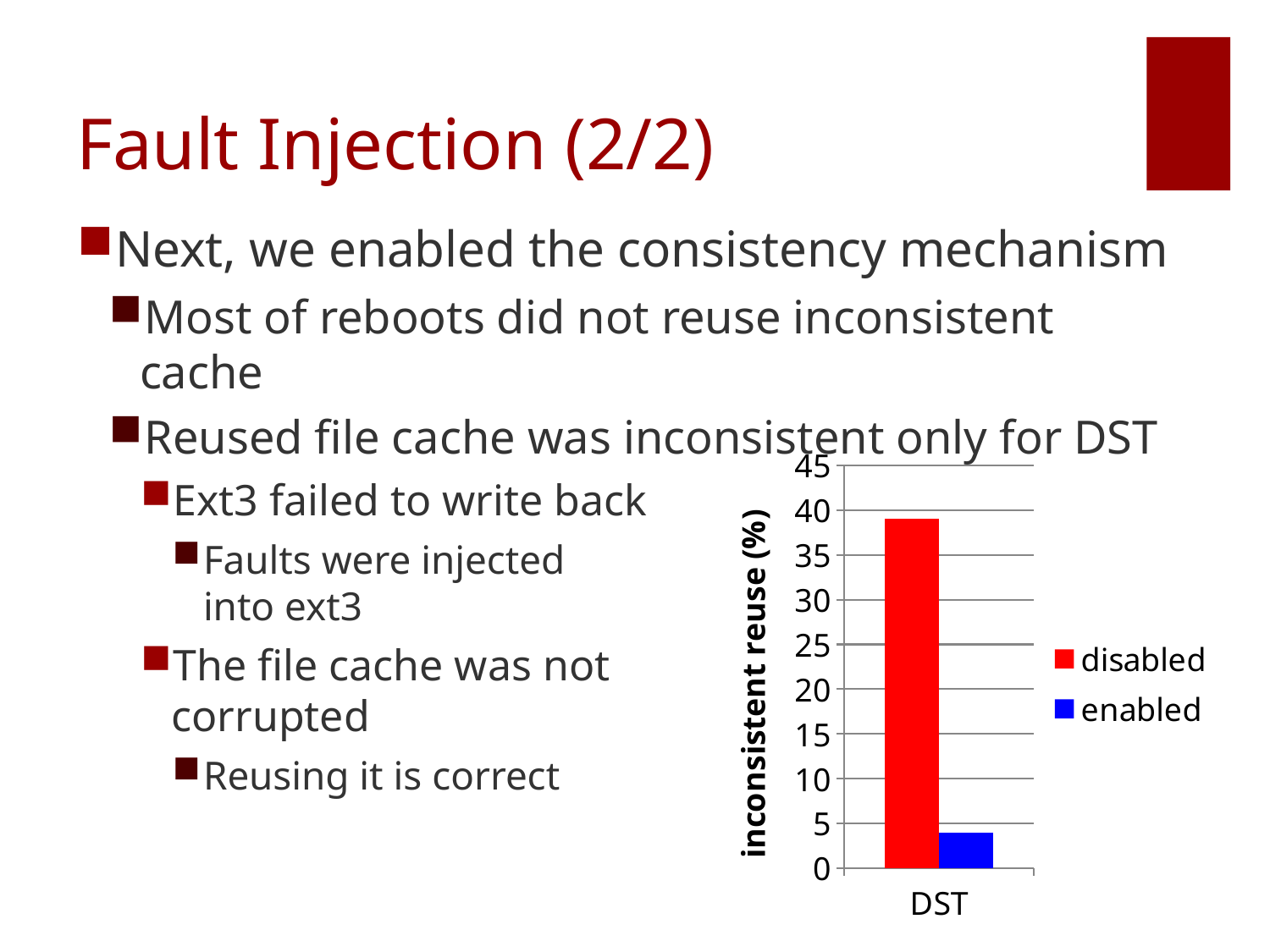
What is the highest value shown on the y axis of the chart? 45 What is the title of the y axis of the chart? inconsistent reuse (%) Which series has the larger value for DST, disabled or enabled? disabled Is the value for disabled at DST greater or less than 35? greater Is the value for enabled at DST greater or less than 5? less Is the value for disabled at DST greater or less than 40? less What kind of chart is shown on the slide? bar chart How many categories are shown on the x axis of the chart? 1 What is the label of the category on the x axis of the chart? DST How many series does the chart's legend list? 2